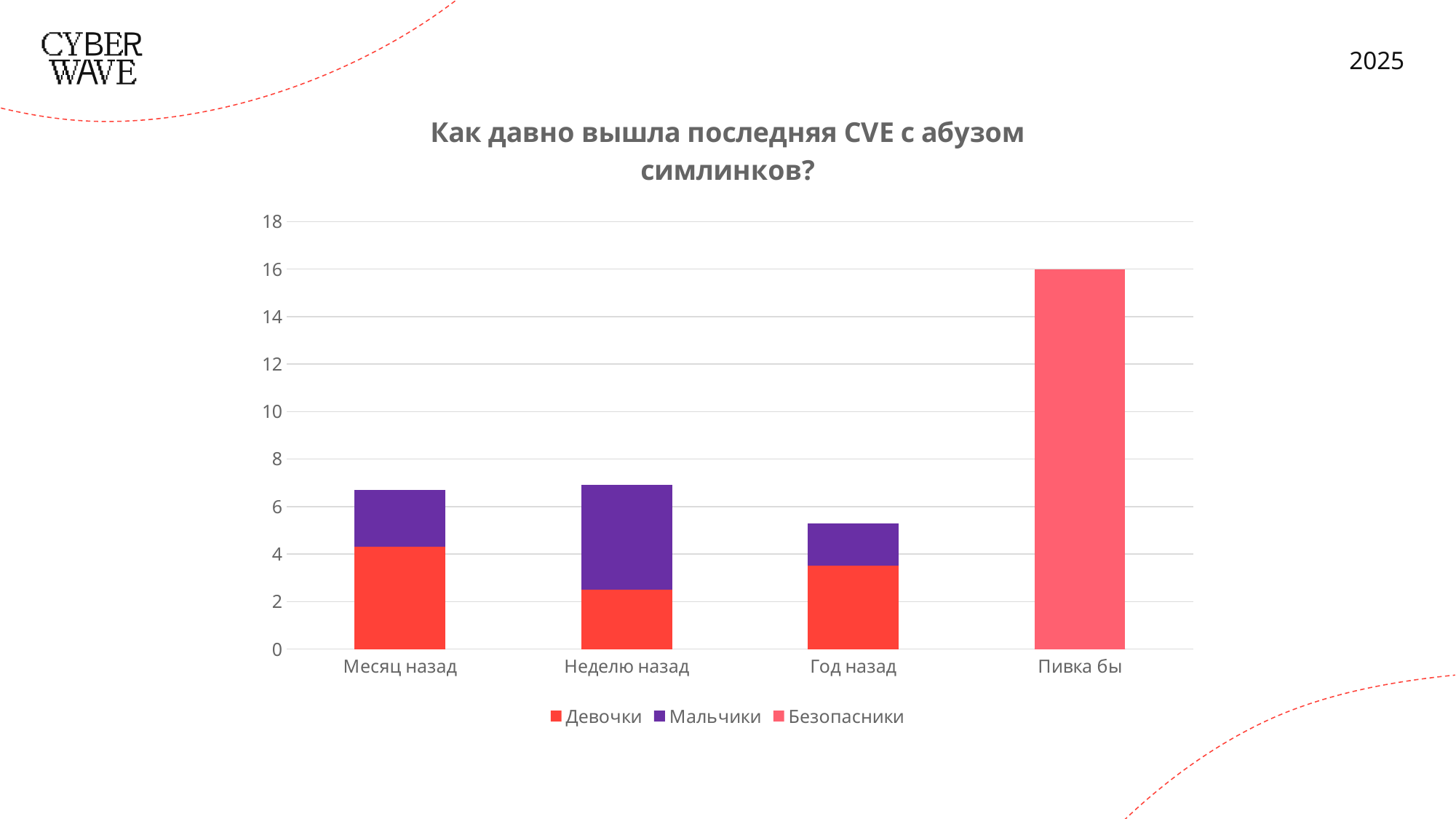
What kind of chart is shown on the slide? Bar chart How many categories are shown on the x axis of the chart? 4 Is the value for Пивка бы greater or less than 10? greater Is the total height of the stacked bar for Год назад greater or less than 6? less Which category has the tallest bar in the chart? Пивка бы Which category has the larger Мальчики value: Неделю назад or Год назад? Неделю назад What is the value of the Безопасники bar for Пивка бы? 16 How many series does the chart legend list? 3 What is the title of the chart? Как давно вышла последняя CVE с абузом симлинков? Is the Девочки value for Неделю назад greater or less than 4? less Which category has the shortest stacked bar in the chart? Год назад Which category has the larger Девочки value: Месяц назад or Неделю назад? Месяц назад